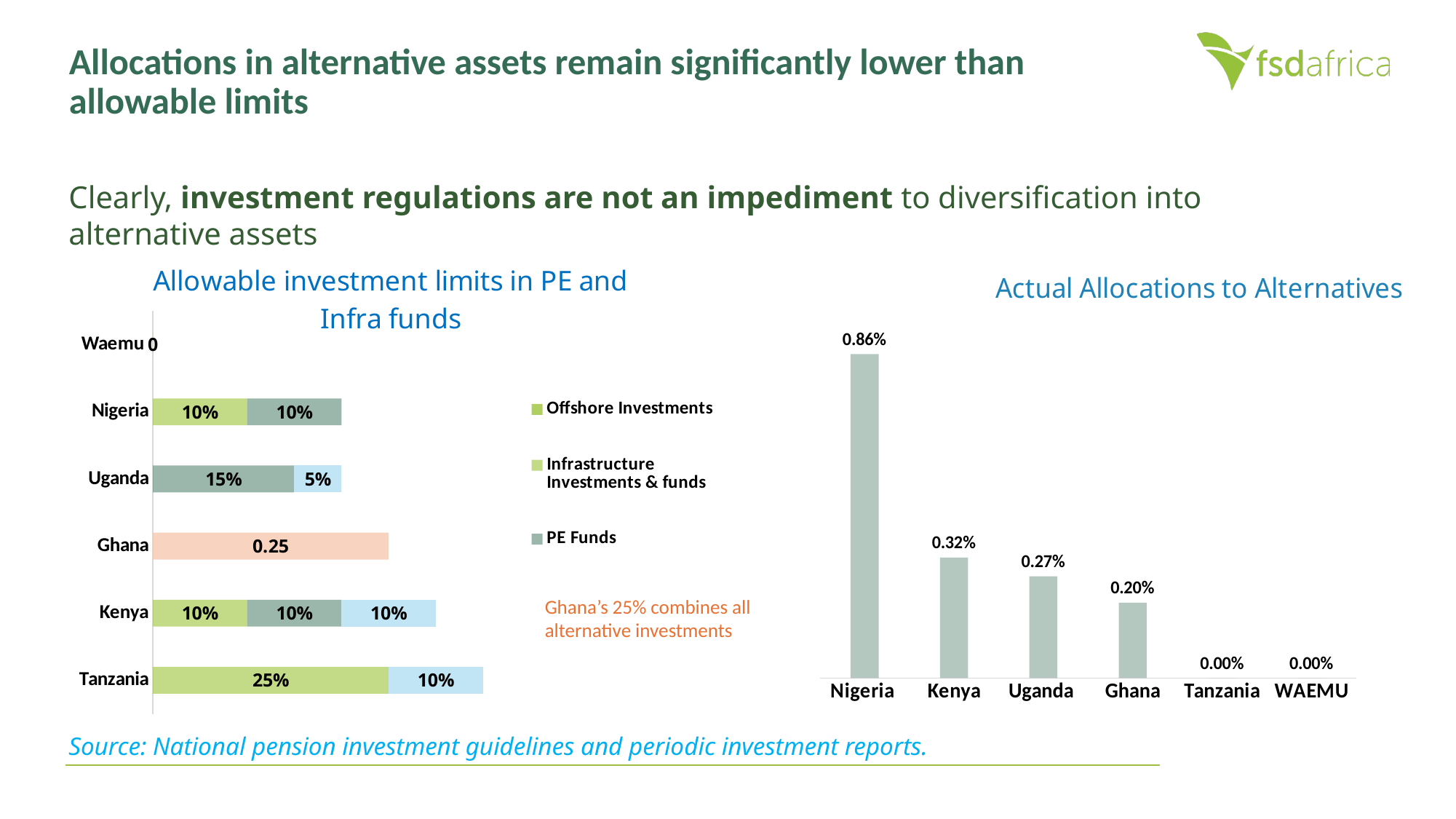
What kind of chart is the 'Actual Allocations to Alternatives' chart? Bar chart In the 'Actual Allocations to Alternatives' chart, which country has the highest allocation? Nigeria In the 'Allowable investment limits in PE and Infra funds' chart, what is the total of the stacked bar for Kenya? 30% In the 'Allowable investment limits in PE and Infra funds' chart, what is the total of the stacked bar for Tanzania? 35% In the 'Actual Allocations to Alternatives' chart, which is larger, the value for Kenya or the value for Uganda? Kenya In the 'Allowable investment limits in PE and Infra funds' chart, what value is labelled on the bar for Ghana? 0.25 In the 'Actual Allocations to Alternatives' chart, do the values rise or fall from left to right? Fall How many series does the legend of the 'Allowable investment limits in PE and Infra funds' chart list? 3 How many countries are shown in the 'Actual Allocations to Alternatives' chart? 6 In the 'Actual Allocations to Alternatives' chart, what is the value for Ghana? 0.20% In the 'Actual Allocations to Alternatives' chart, what is the difference between the values for Nigeria and Kenya? 0.54% In the 'Actual Allocations to Alternatives' chart, what is the value for Nigeria? 0.86%